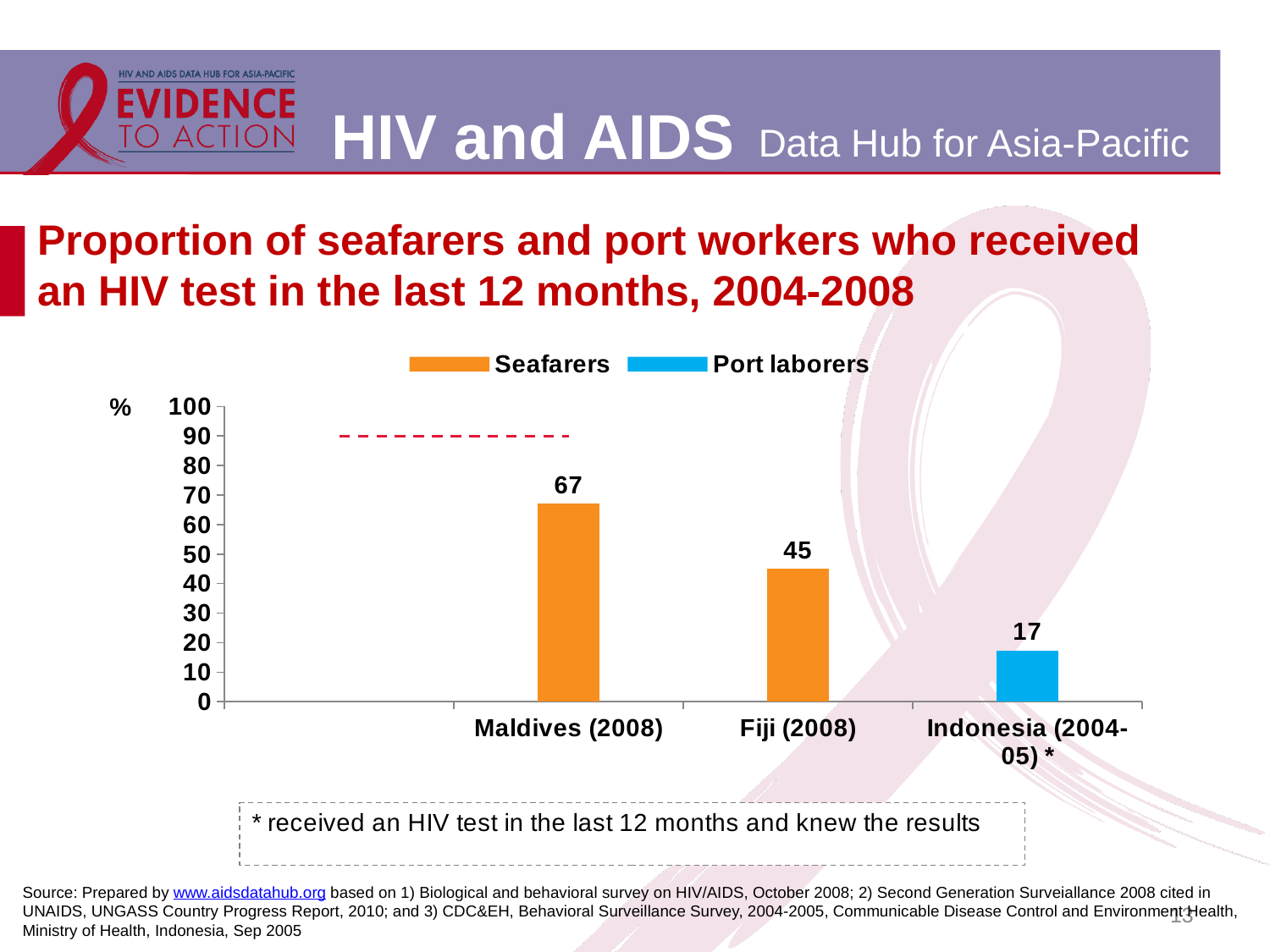
Which category has the highest value? Maldives (2008) What is the difference between the values for Fiji (2008) and Indonesia (2004-05)? 28 How many series does the legend list? 2 What is the difference between the values for Maldives (2008) and Fiji (2008)? 22 Which category has the lowest value? Indonesia (2004-05) What is the value for Maldives (2008)? 67 Which is larger, the value for Fiji (2008) or the value for Indonesia (2004-05)? Fiji (2008) How many categories are shown on the x axis? 3 What is the value for Indonesia (2004-05)? 17 What is the value for Fiji (2008)? 45 Is the value for Maldives (2008) greater or less than 60? greater What kind of chart is shown on the slide? bar chart